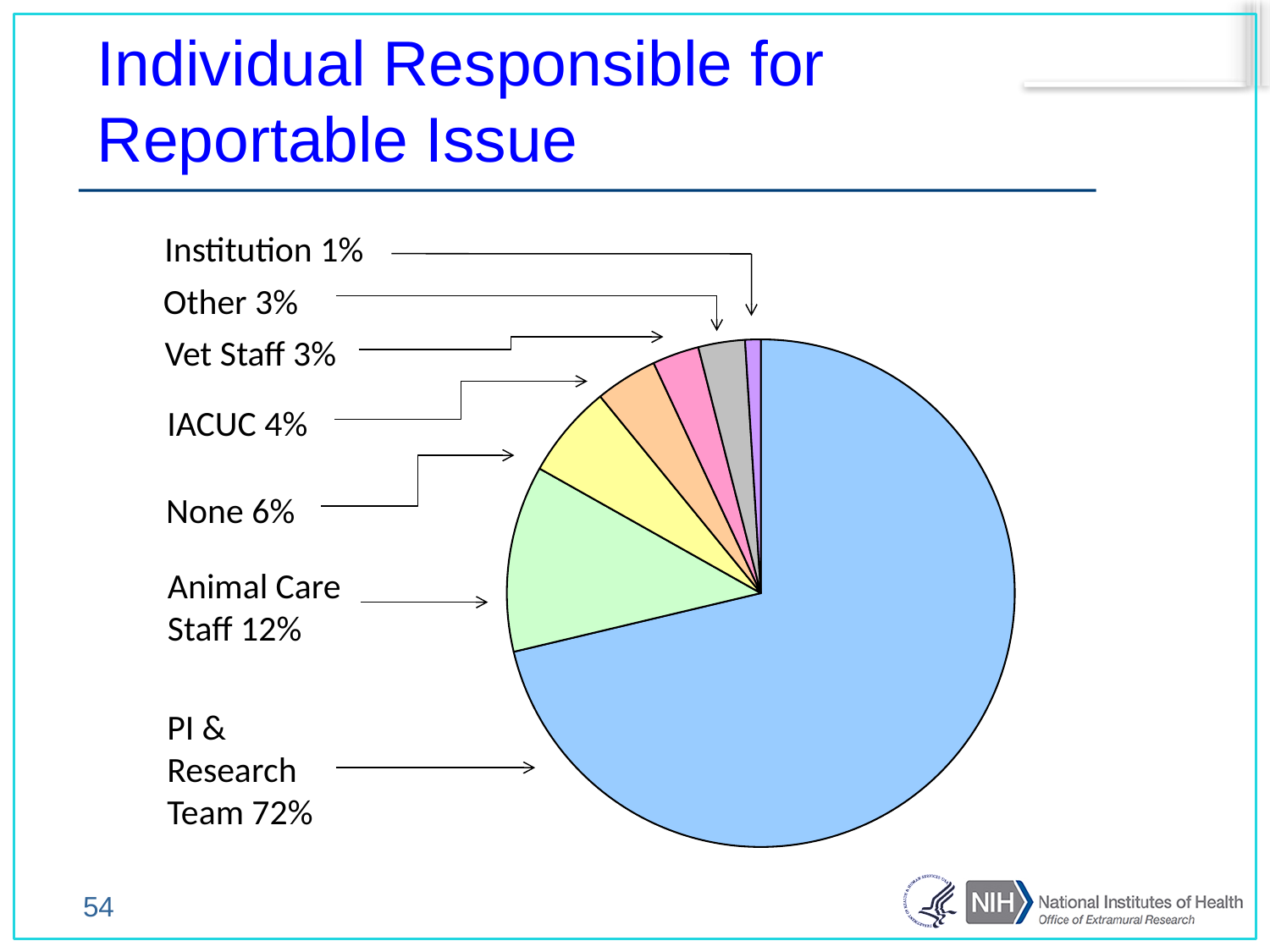
What percentage is shown for None? 6% What share of the pie is labelled for PI & Research Team? 72% Which category has the smallest slice of the pie? Institution What share of the pie is labelled for Animal Care Staff? 12% Which category has the largest slice of the pie? PI & Research Team How many slices does the pie chart have? 7 Which is larger, the share for None or the share for IACUC? None What is the difference in percentage points between PI & Research Team and Animal Care Staff? 60 What kind of chart is shown on the slide? pie chart What is the title of the chart on the slide? Individual Responsible for Reportable Issue What percentage is shown for IACUC? 4% What percentage is shown for Institution? 1%